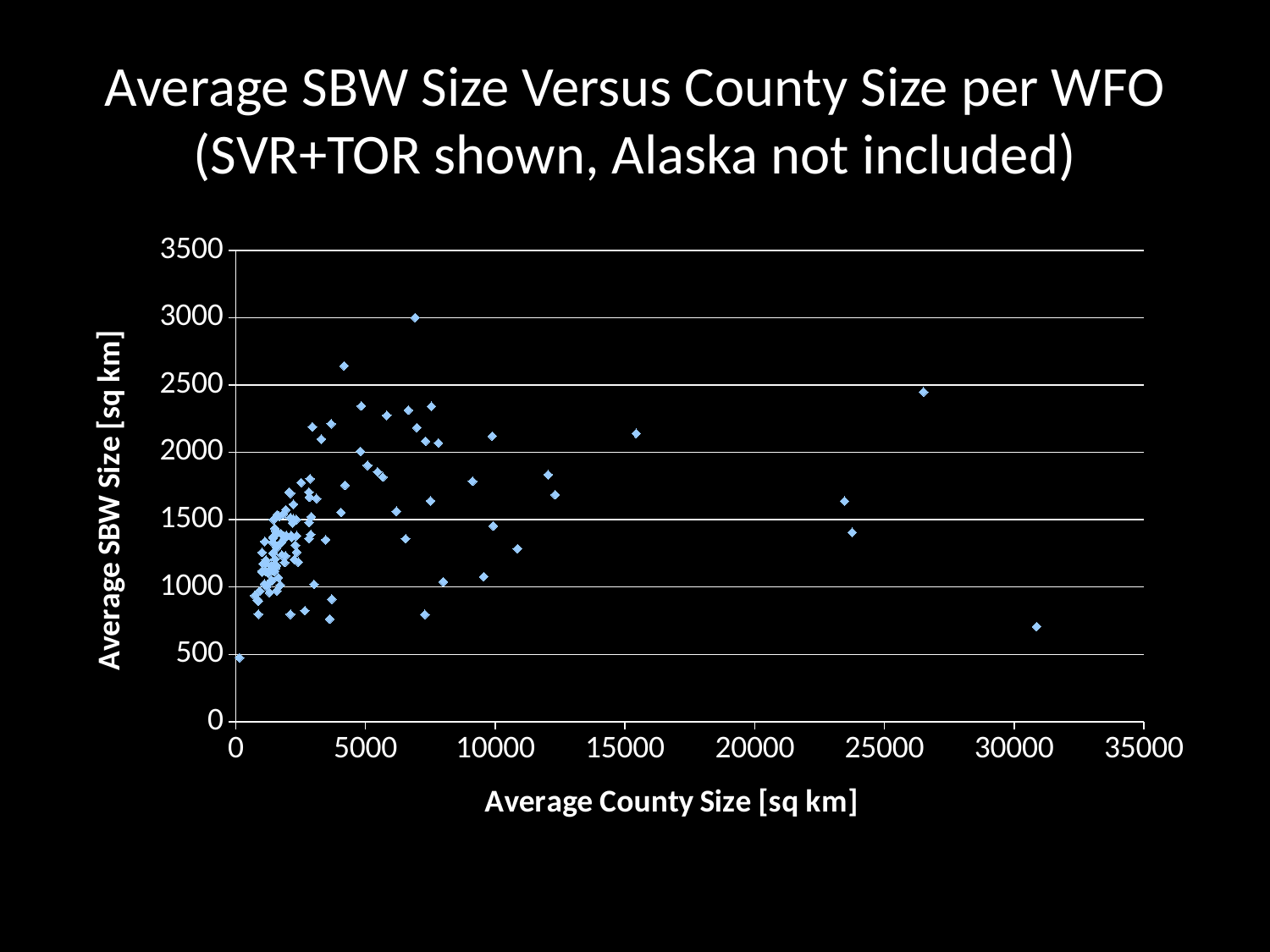
Is the Average SBW Size of the highest point on the chart greater or less than 2500? greater What kind of chart is shown on the slide? scatter plot What is the title of the chart? Average SBW Size Versus County Size per WFO (SVR+TOR shown, Alaska not included) Is the Average SBW Size of the point with the largest Average County Size greater or less than 1000? less Is the Average SBW Size of the rightmost point greater or less than 500? greater How many points have an Average County Size greater than 20000? 4 What is the label on the vertical axis of the chart? Average SBW Size [sq km] How many points have an Average County Size greater than 25000? 2